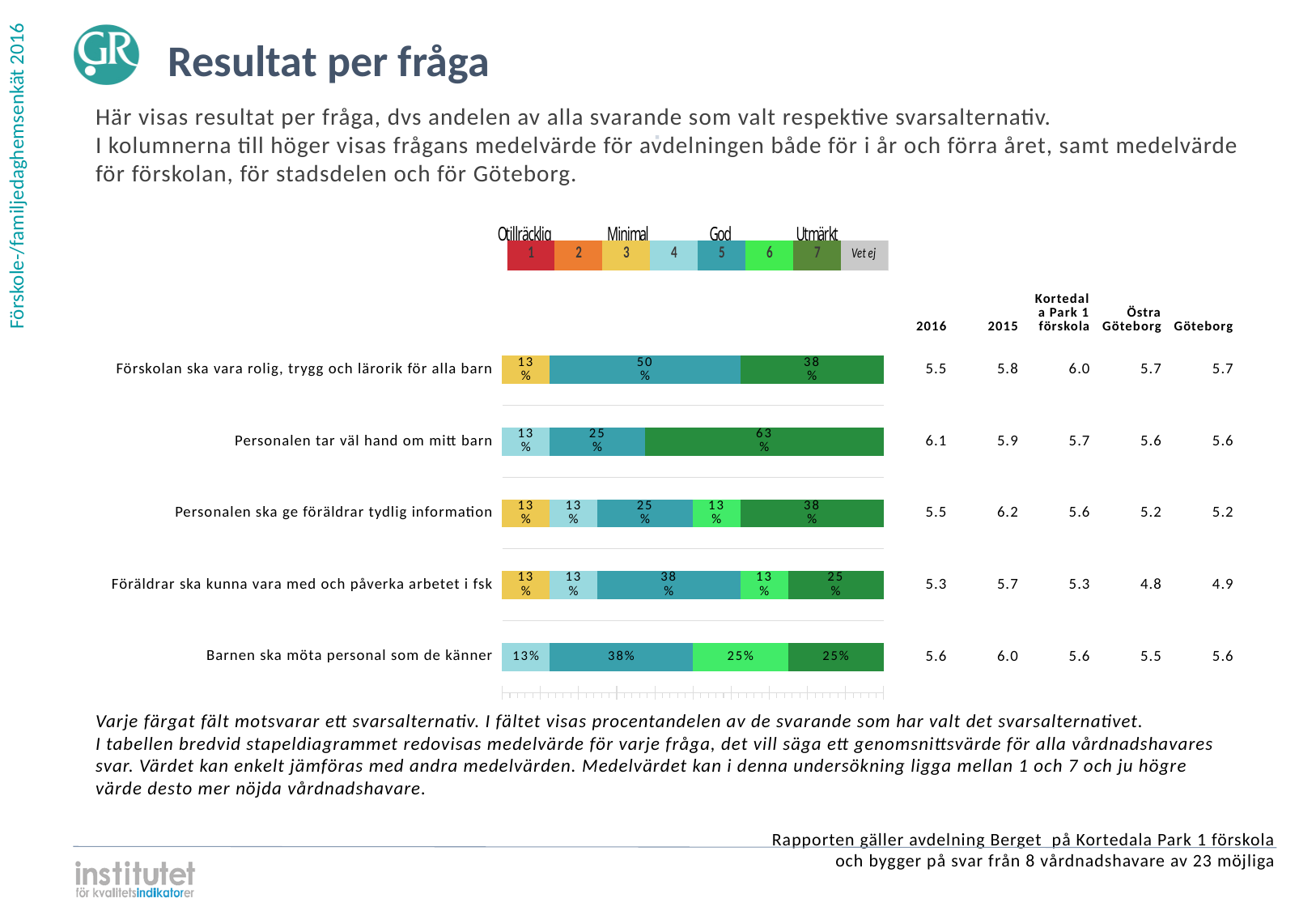
What is the Göteborg mean value shown for 'Föräldrar ska kunna vara med och påverka arbetet i fsk'? 4.9 How many questions (categories) are plotted in the bar chart? 5 What percentage of respondents chose the teal (5) option for 'Förskolan ska vara rolig, trygg och lärorik för alla barn'? 50% What kind of chart is shown on the slide? Stacked bar chart What is the 2016 mean value shown for 'Personalen tar väl hand om mitt barn'? 6.1 Which question has the largest share of respondents choosing the dark green (7) option? Personalen tar väl hand om mitt barn What percentage of respondents chose the bright green (6) option for 'Barnen ska möta personal som de känner'? 25% What is the difference between the dark green (7) share for 'Personalen tar väl hand om mitt barn' and for 'Personalen ska ge föräldrar tydlig information'? 25 percentage points For 'Förskolan ska vara rolig, trygg och lärorik för alla barn', which is larger: the teal (5) share or the dark green (7) share? The teal (5) share How many response options does the legend above the chart list? 8 What is the teal (5) share for 'Föräldrar ska kunna vara med och påverka arbetet i fsk'? 38% What percentage of respondents chose the dark green (7, Utmärkt) option for 'Personalen tar väl hand om mitt barn'? 63%